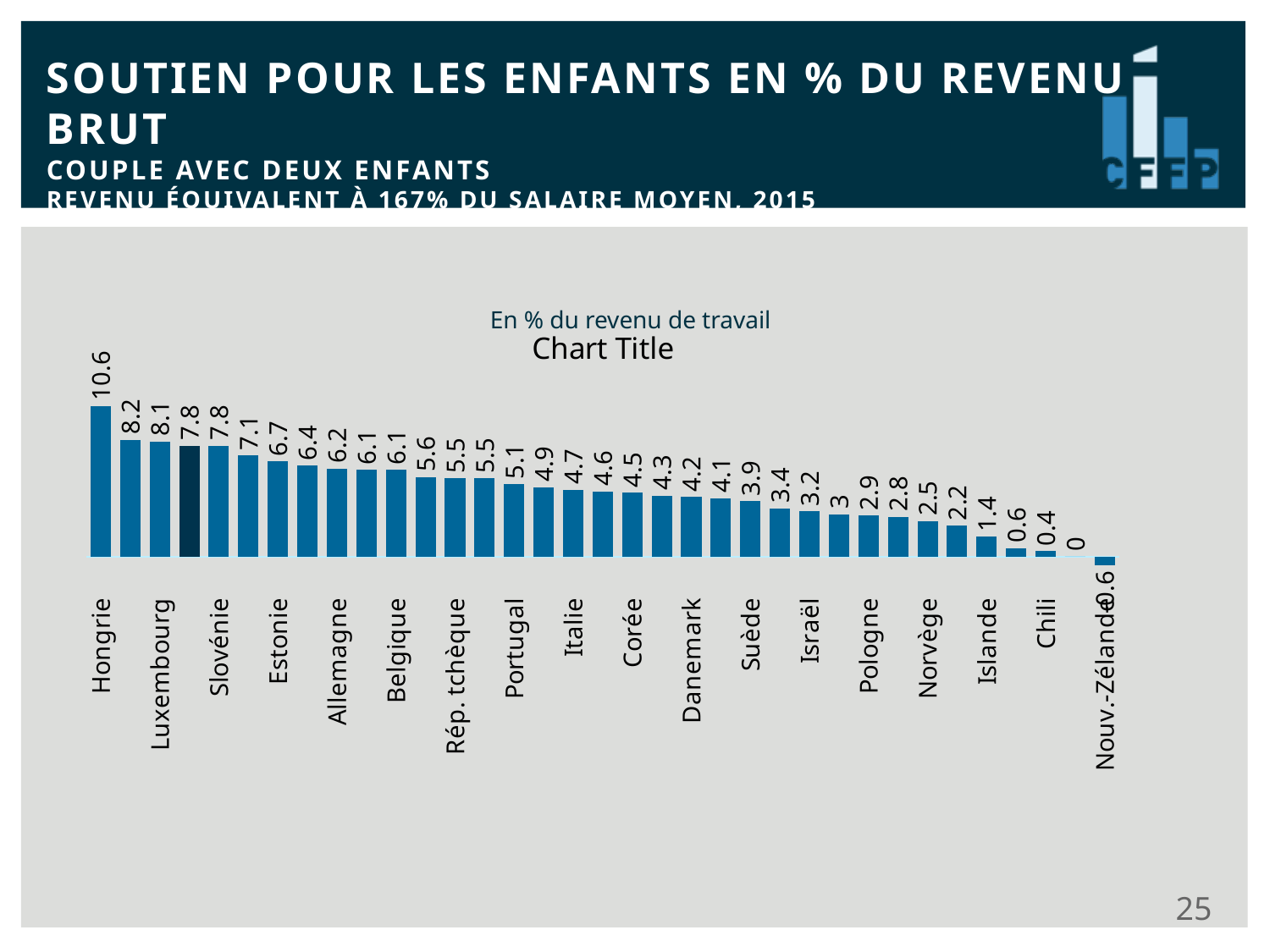
What is the value for Portugal? 5.1 What is the value for Luxembourg? 8.1 Which country has the highest value? Hongrie What is the value for Islande? 1.4 What is the value for Suède? 3.9 Which is larger, the value for Belgique or the value for Danemark? Belgique Which country has the lowest value? Nouv.-Zélande What text appears just above the chart title? En % du revenu de travail What is the value for Hongrie? 10.6 What type of chart is shown on the slide? bar chart What is the difference between the values for Hongrie and Luxembourg? 2.5 Do the values rise or fall from left to right along the x axis? fall